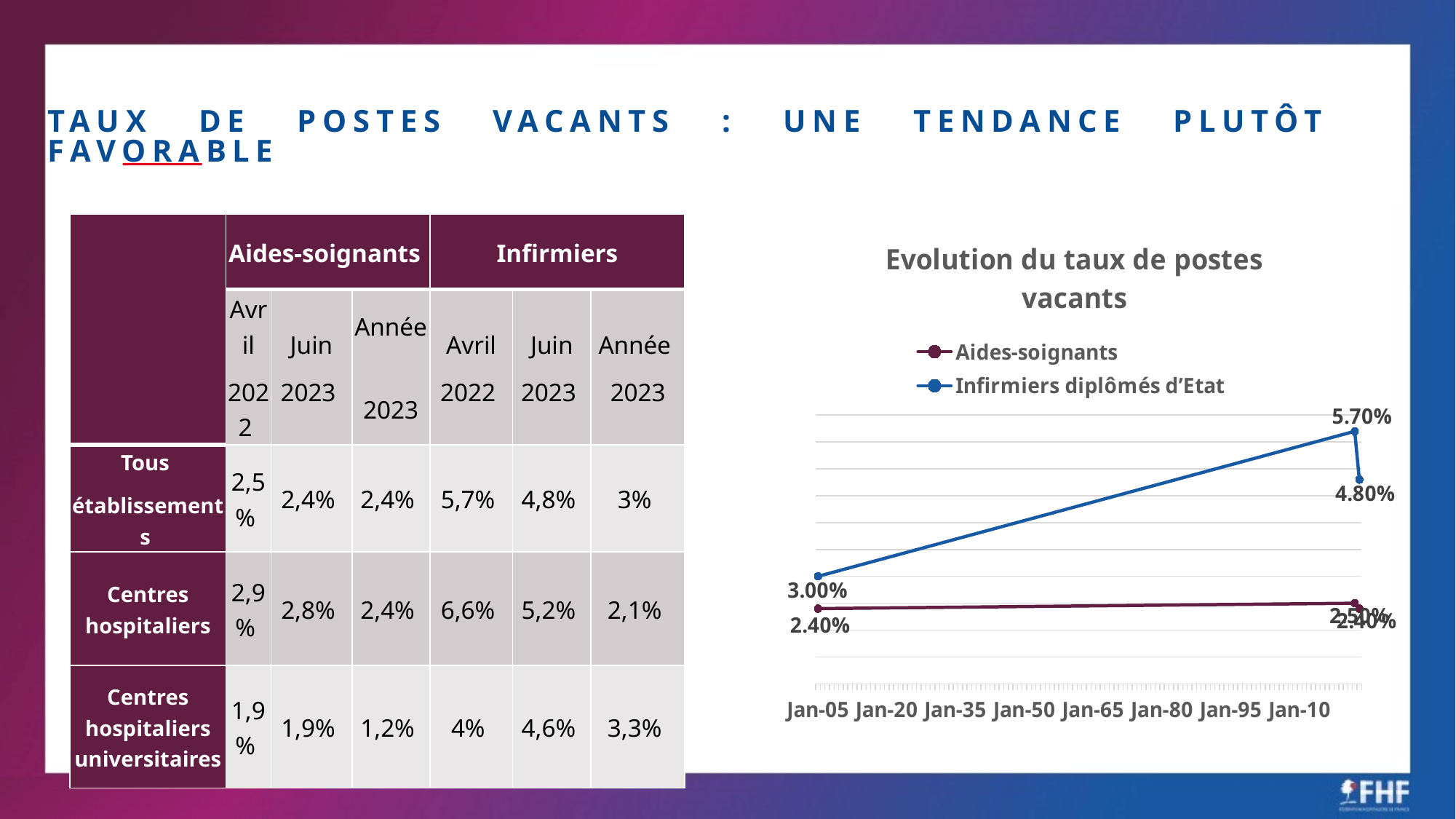
What is the last (rightmost) value labelled for the Infirmiers diplômés d'Etat series? 4.80% What is the first (leftmost) value labelled for the Infirmiers diplômés d'Etat series? 3.00% What is the first (leftmost) value labelled for the Aides-soignants series? 2.40% What is the highest value labelled for the Infirmiers diplômés d'Etat series? 5.70% What is the difference between the peak value of the Infirmiers diplômés d'Etat series (5.70%) and its last value (4.80%)? 0.90% How many data points are plotted for the Infirmiers diplômés d'Etat series? 3 What type of chart is shown on the slide? line chart What is the title of the chart? Evolution du taux de postes vacants Which series is drawn in blue on the chart? Infirmiers diplômés d'Etat Which series has higher values throughout the chart, Aides-soignants or Infirmiers diplômés d'Etat? Infirmiers diplômés d'Etat How many series does the chart legend list? 2 What is the lowest value labelled for the Infirmiers diplômés d'Etat series? 3.00%